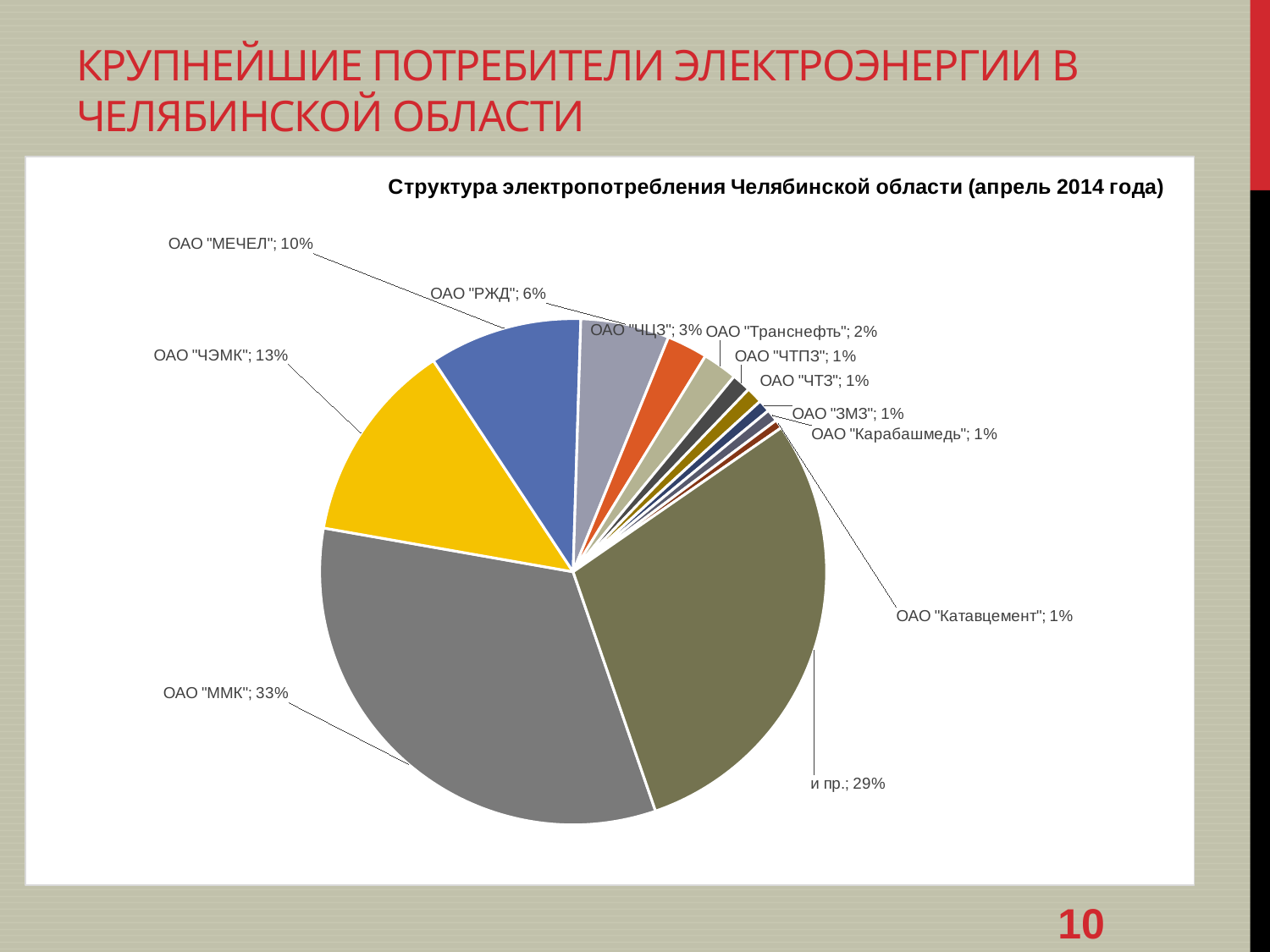
What share is labelled for ОАО "Транснефть"? 2% What share of electricity consumption does ОАО "ММК" account for? 33% What share is labelled for ОАО "РЖД"? 6% How many slices does the pie chart have? 12 Which has a larger share, ОАО "ЧЭМК" or ОАО "МЕЧЕЛ"? ОАО "ЧЭМК" What is the difference between the shares of ОАО "ММК" and "и пр."? 4% Which slice has the largest share of the pie? ОАО "ММК" What is the title of the chart? Структура электропотребления Челябинской области (апрель 2014 года) What kind of chart is shown on the slide? Pie chart